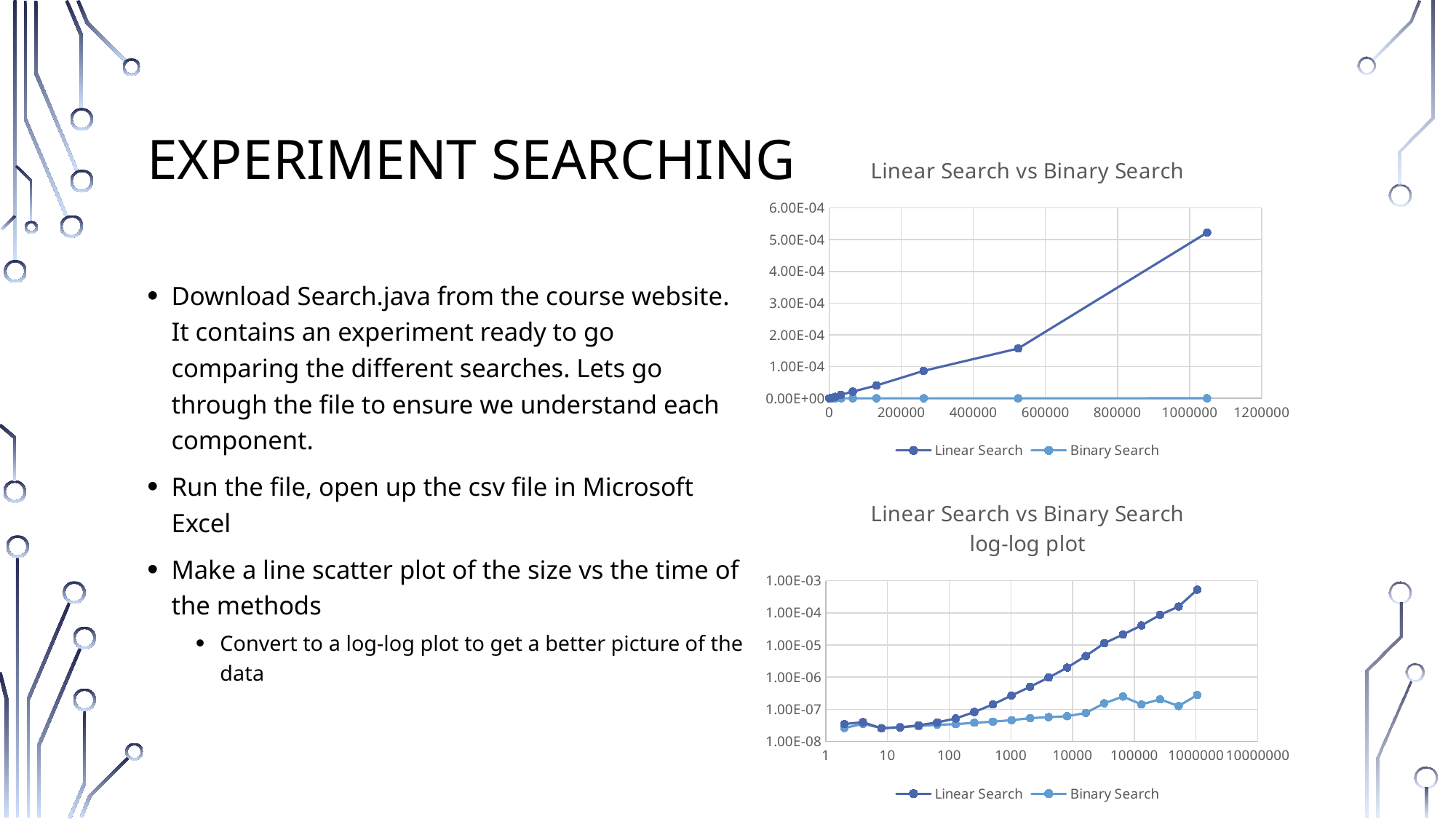
In the top chart titled 'Linear Search vs Binary Search', how many series does the legend list? 2 In the bottom chart titled 'Linear Search vs Binary Search log-log plot', is the Linear Search value at 1000000 greater or less than 1.00E-04? greater In the top chart titled 'Linear Search vs Binary Search', is the Linear Search value at the largest input size (about 1000000) greater or less than 4.00E-04? greater What is the title of the bottom chart on the slide? Linear Search vs Binary Search log-log plot In the top chart titled 'Linear Search vs Binary Search', is the Binary Search value at roughly 1000000 greater or less than 1.00E-04? less In the top chart titled 'Linear Search vs Binary Search', what kind of chart is shown? line chart In the top chart titled 'Linear Search vs Binary Search', which series has the larger value at the largest input size, Linear Search or Binary Search? Linear Search In the bottom chart titled 'Linear Search vs Binary Search log-log plot', how many series does the legend list? 2 In the top chart titled 'Linear Search vs Binary Search', does the Linear Search series rise or fall as the input size increases? rise In the bottom chart titled 'Linear Search vs Binary Search log-log plot', which series has the larger value at 100000, Linear Search or Binary Search? Linear Search